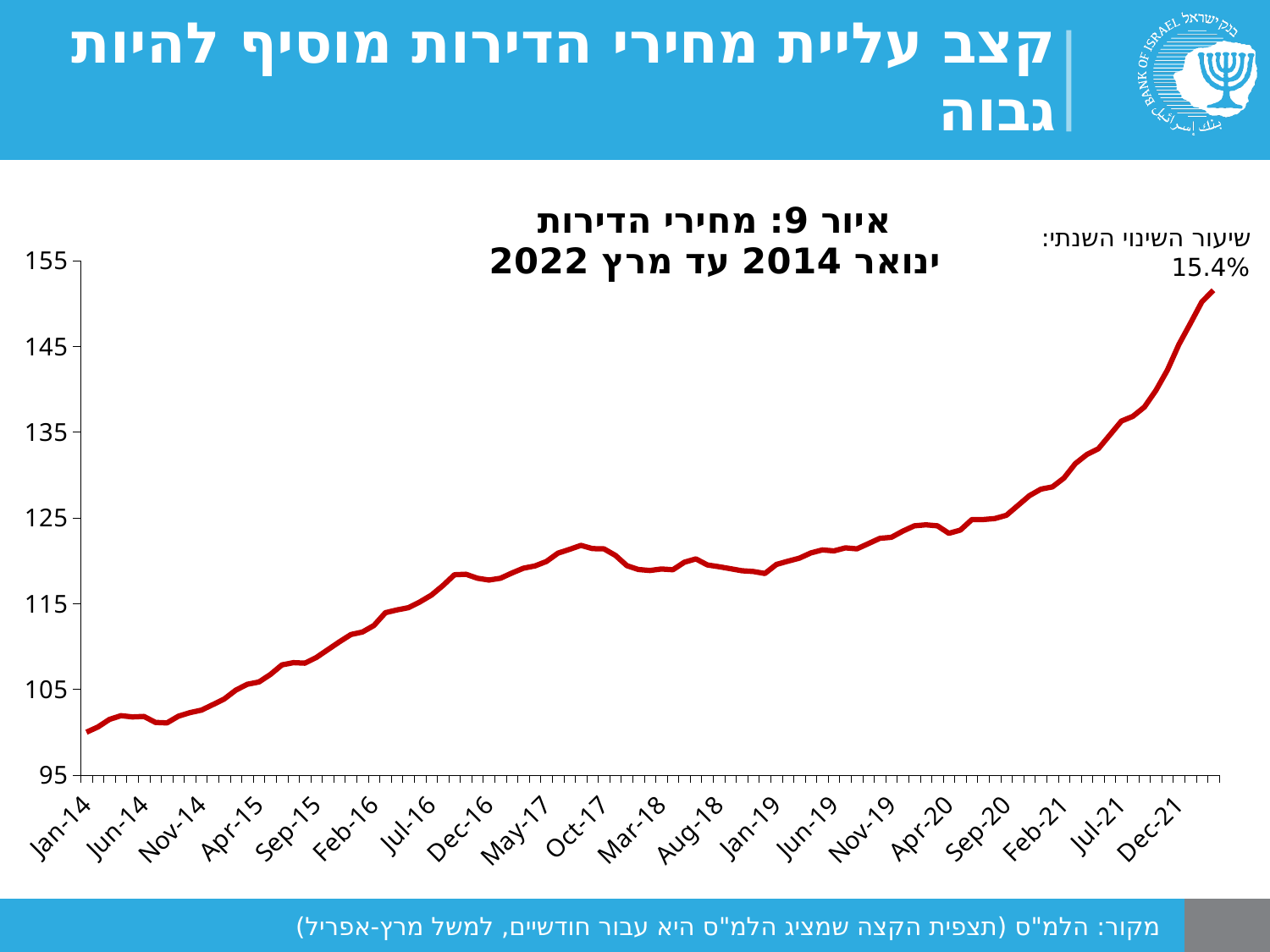
Is the value for Mar-18 greater or less than 125? less Overall, do the values rise or fall from Jan-14 to the end of the series? rise Is the value for Feb-21 greater or less than 125? greater Is the value for Jan-14 greater or less than 105? less What is the lowest value shown on the vertical axis? 95 What is the title of the chart? איור 9: מחירי הדירות ינואר 2014 עד מרץ 2022 What kind of chart is shown on the slide? line chart Which is larger, the value for Jan-14 or the value for Dec-21? Dec-21 What is the annual rate of change (שיעור השינוי השנתי) shown on the chart? 15.4%